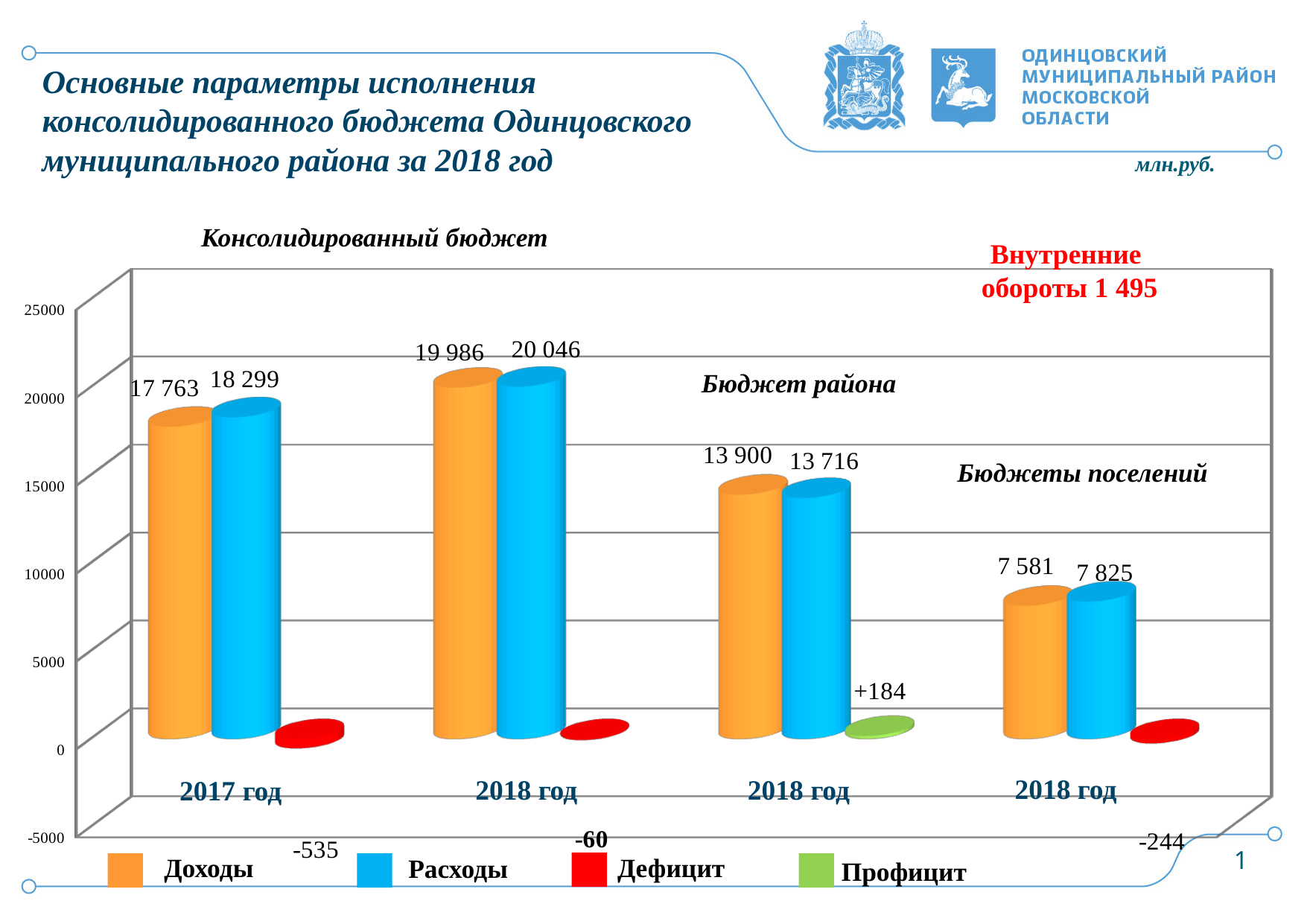
What is the Профицит value shown for Бюджет района in 2018 год? +184 What is the Дефицит value shown for the consolidated budget in 2017 год? -535 Which group has the lowest Доходы value? Бюджеты поселений, 2018 год For Бюджет района in 2018 год, which is larger: Доходы or Расходы? Доходы What is the difference between Расходы and Доходы for the consolidated budget in 2018 год? 60 What is the value of Расходы for the consolidated budget (Консолидированный бюджет) in 2018 год? 20 046 Which group has the highest Расходы value? Консолидированный бюджет, 2018 год What is the value of Расходы for Бюджеты поселений in 2018 год? 7 825 How many series does the legend list? 4 What is the value of Доходы for the consolidated budget (Консолидированный бюджет) in 2017 год? 17 763 What is the value of Доходы for Бюджет района in 2018 год? 13 900 What type of chart is shown on the slide? Bar chart